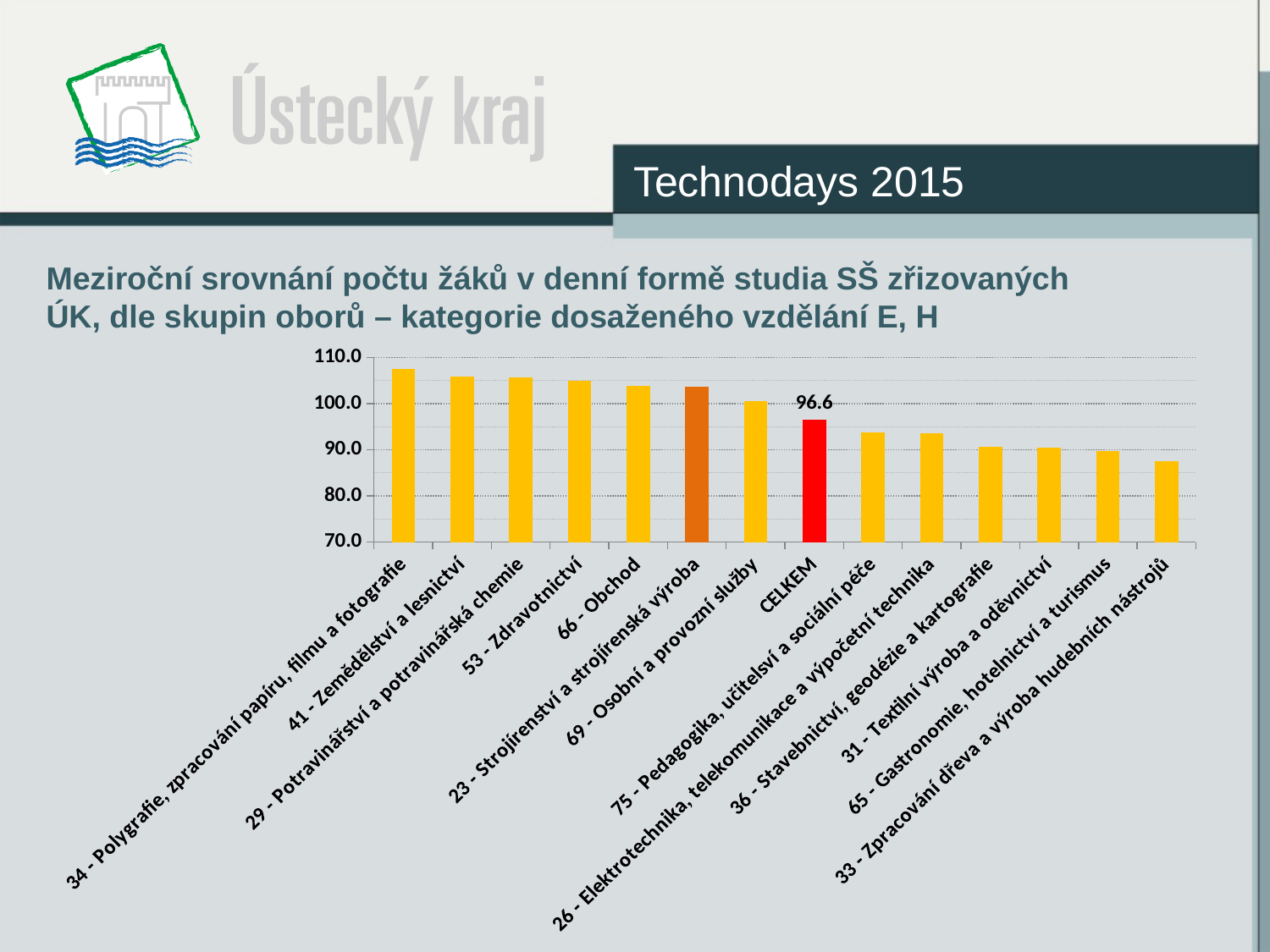
Is the value for 75 - Pedagogika, učitelství a sociální péče greater or less than 100.0? less Which category has the highest bar? 34 - Polygrafie, zpracování papíru, filmu a fotografie What kind of chart is shown on the slide? Bar chart Is the value for 33 - Zpracování dřeva a výroba hudebních nástrojů greater or less than 90.0? less Which is larger, the value for 53 - Zdravotnictví or the value for 36 - Stavebnictví, geodézie a kartografie? 53 - Zdravotnictví Do the bar values generally rise or fall from left to right along the x axis? fall Which category's bar is coloured orange, different from the yellow bars? 23 - Strojírenství a strojírenská výroba Is the value for 66 - Obchod greater or less than 100.0? greater What is the value shown for CELKEM? 96.6 What colour is the CELKEM bar? Red Which category has the lowest bar? 33 - Zpracování dřeva a výroba hudebních nástrojů How many bars are plotted in the chart? 14